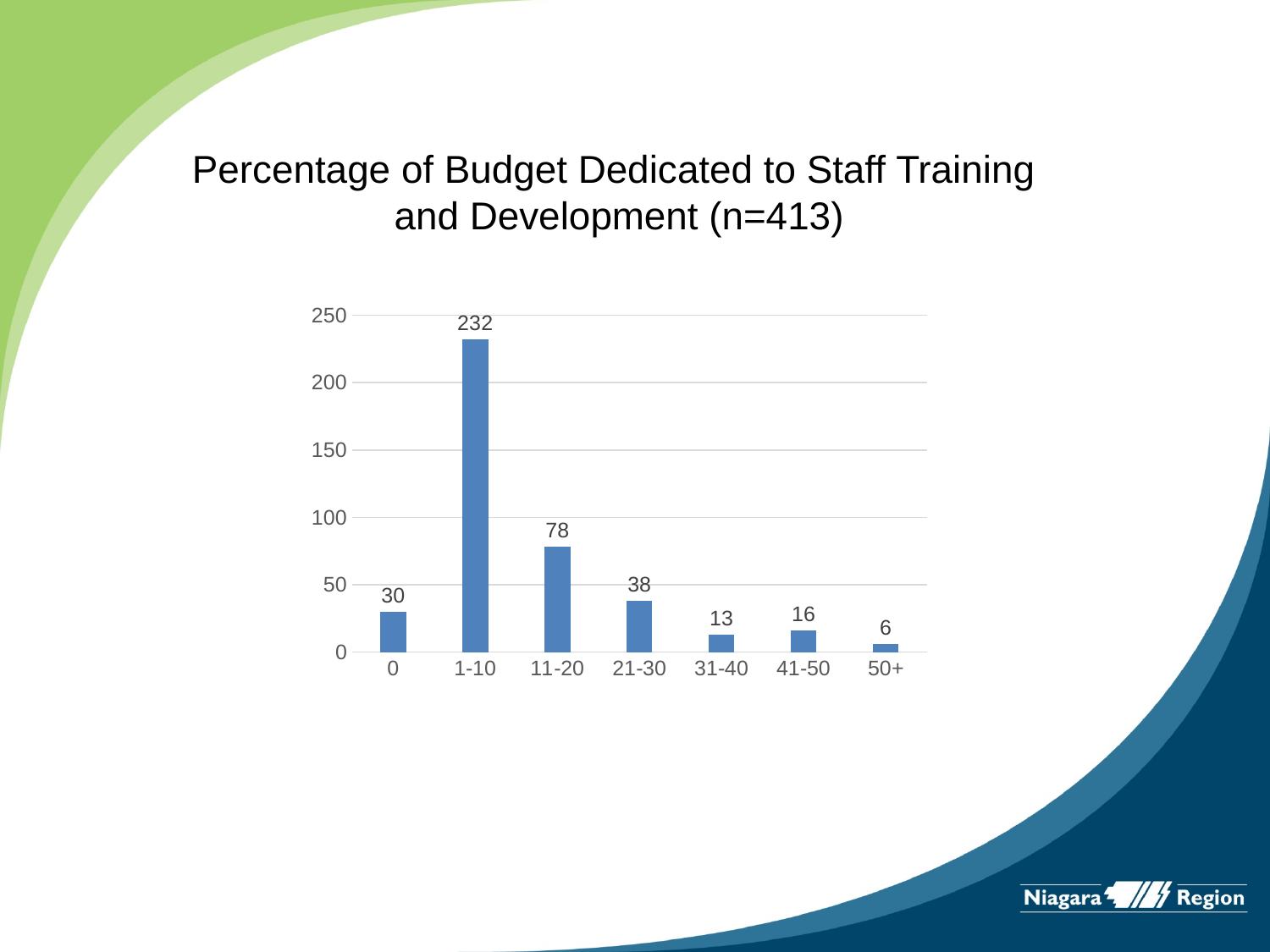
What is the value for the 1-10 category? 232 What is the title of the chart? Percentage of Budget Dedicated to Staff Training and Development (n=413) What kind of chart is shown on the slide? bar chart Which category has the highest value? 1-10 What is the value for the 50+ category? 6 Is the value for 11-20 greater or less than 100? less Which is larger, the value for 0 or the value for 21-30? 21-30 How many categories are shown on the x axis? 7 What is the difference between the values for 1-10 and 11-20? 154 What is the difference between the values for 41-50 and 31-40? 3 What is the value for the 21-30 category? 38 Which category has the lowest value? 50+